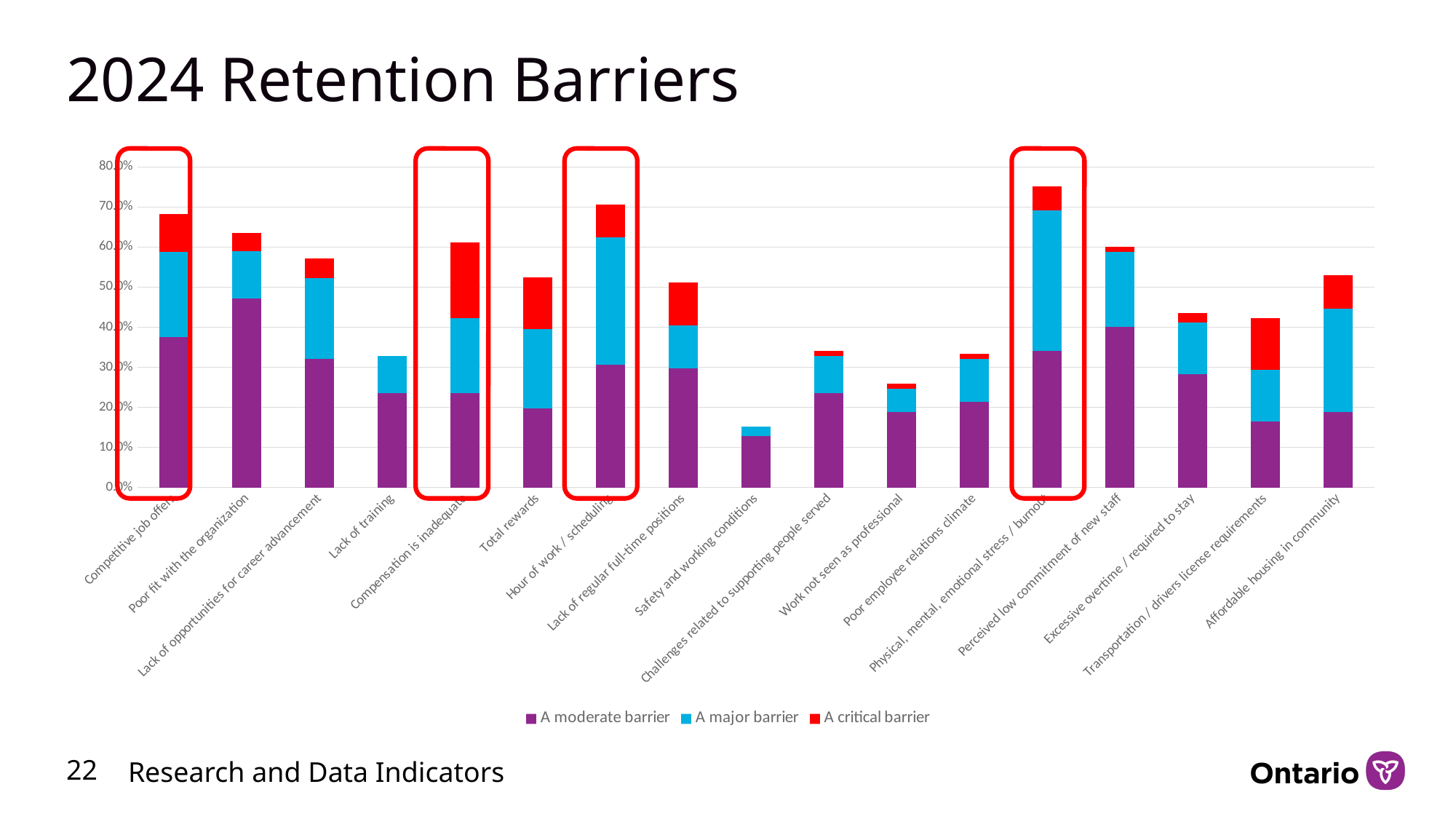
Is the total bar for Physical, mental, emotional stress / burnout greater or less than 70.0%? greater Is the total bar for Safety and working conditions greater or less than 20.0%? less How many retention barrier categories are plotted along the x axis? 17 Which category has the lowest total stacked bar? Safety and working conditions How many series does the legend list? 3 Which category has the highest total stacked bar? Physical, mental, emotional stress / burnout What kind of chart is shown on the slide? Stacked bar chart What colour represents 'A critical barrier' in the legend? Red Which has the larger total bar: Compensation is inadequate or Total rewards? Compensation is inadequate How many bars are outlined with red boxes on the chart? 4 Is the total bar for Competitive job offers greater or less than 60.0%? greater Which has the larger total bar: Poor fit with the organization or Lack of opportunities for career advancement? Poor fit with the organization